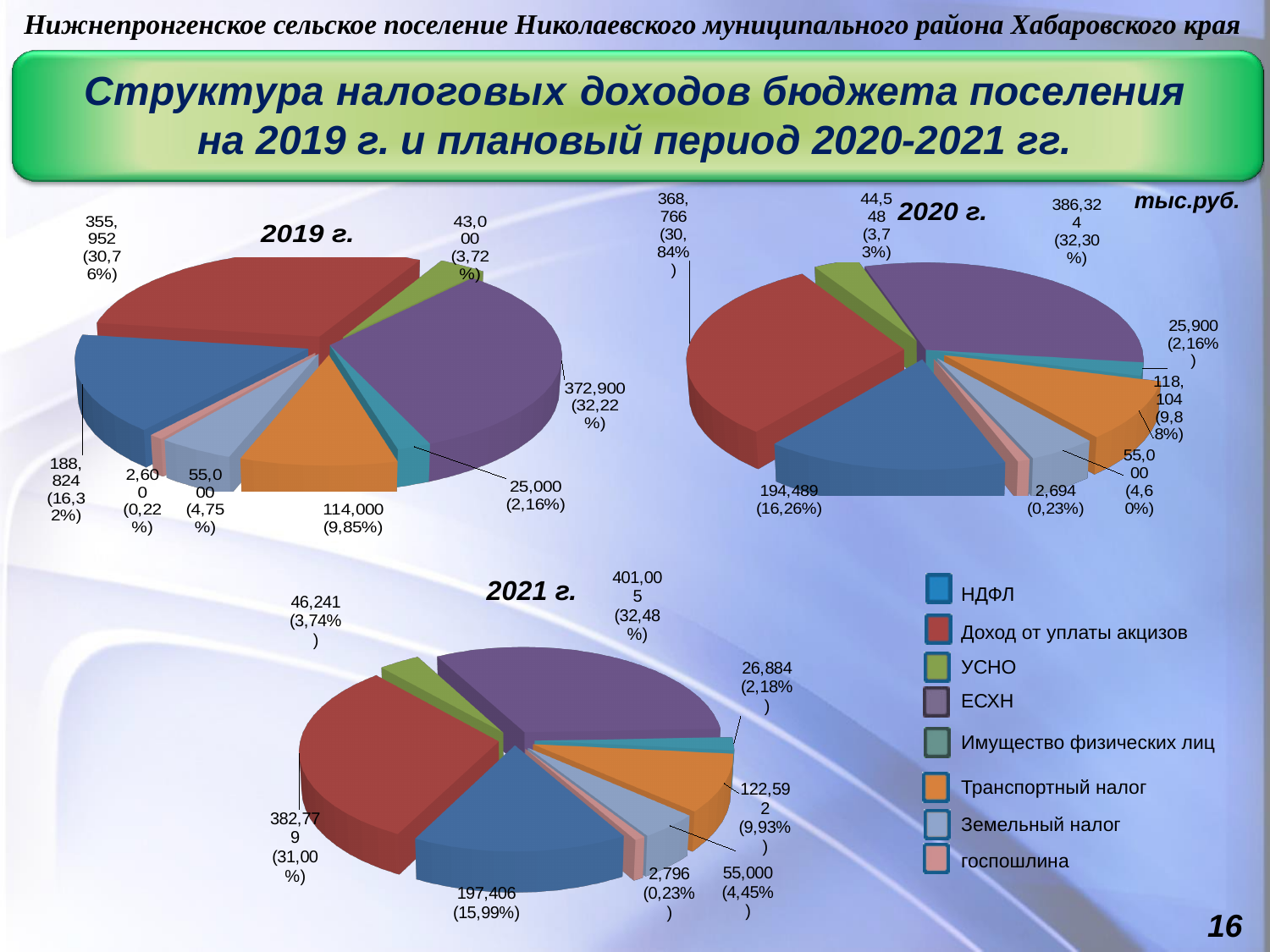
In the 2019 г. chart, what share of the pie does Транспортный налог (orange slice) have? 9,85% What kind of charts are shown on the slide? Pie charts In the 2021 г. chart, what is the value for Земельный налог (light blue slice)? 55,000 (4,45%) In the 2020 г. chart, what is the value for НДФЛ (blue slice)? 194,489 (16,26%) In the 2019 г. chart, what is the value for ЕСХН (purple slice)? 372,900 (32,22%) How many series does the legend list? 8 In the 2020 г. chart, what is the difference between the ЕСХН value (386,324) and the Доход от уплаты акцизов value (368,766)? 17,558 In the 2020 г. chart, which category has the largest slice? ЕСХН In the 2019 г. chart, which category has the smallest slice? госпошлина In the 2021 г. chart, what share of the pie does ЕСХН (purple slice) have? 32,48% In the 2021 г. chart, which is larger: the УСНО slice or the Имущество физических лиц slice? УСНО What unit is stated for the values on the slide? тыс.руб.